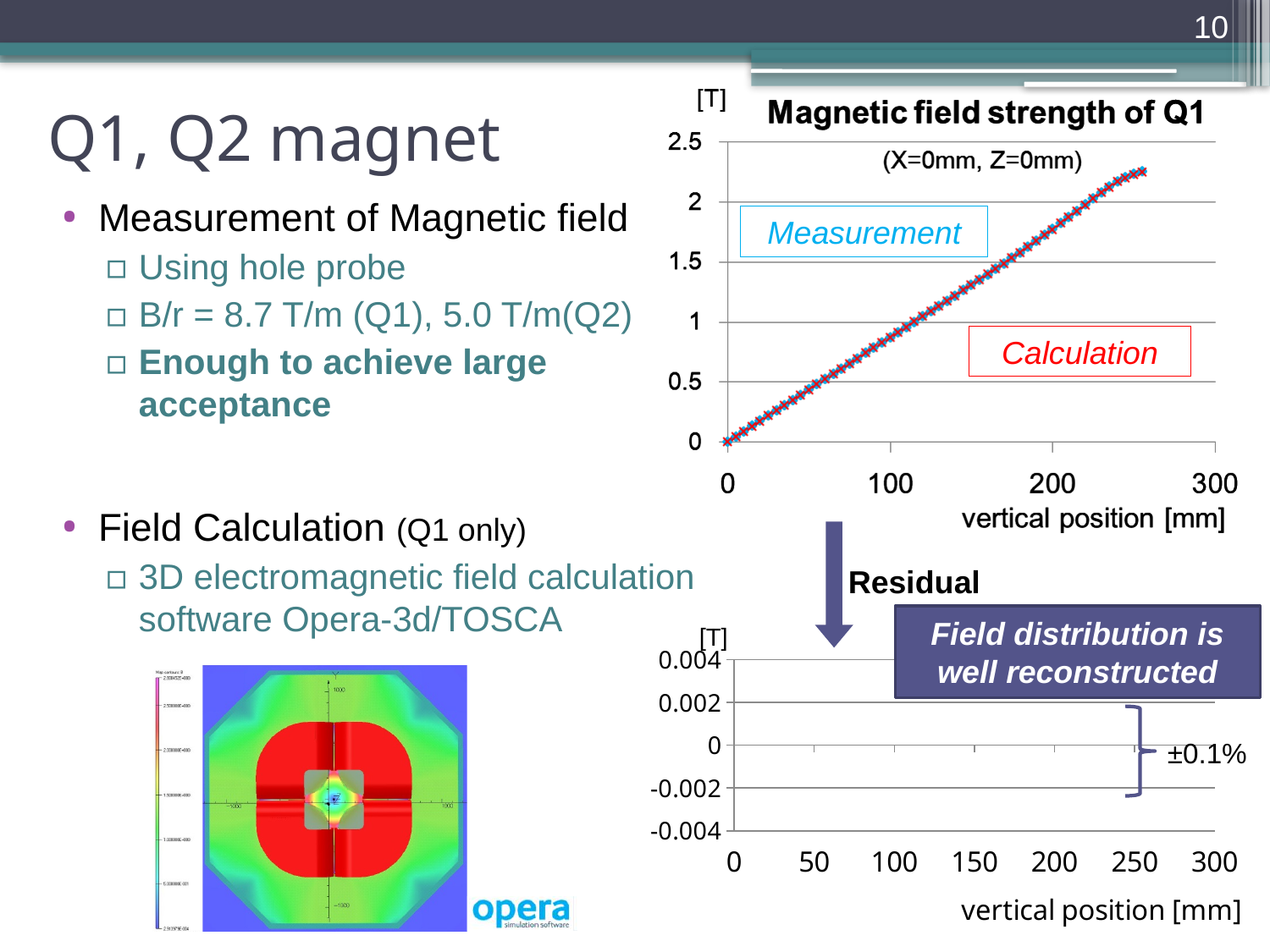
On the chart titled 'Magnetic field strength of Q1', is the field value at a vertical position of 200 mm greater or less than 1.5? greater On the chart titled 'Magnetic field strength of Q1', what are the names of the two series? Measurement and Calculation On the Residual chart at the bottom right, what percentage band is annotated next to the bracket? ±0.1% On the chart titled 'Magnetic field strength of Q1', is the highest plotted field value greater or less than 2.5? less On the chart titled 'Magnetic field strength of Q1', do the values rise or fall as vertical position increases? rise On the chart titled 'Magnetic field strength of Q1', what kind of chart is it? scatter chart On the chart titled 'Magnetic field strength of Q1', is the field value at a vertical position of 100 mm greater or less than 1? less On the chart titled 'Magnetic field strength of Q1', what is the label of the x axis? vertical position [mm] On the Residual chart at the bottom right, what is the lowest value shown on the y axis? -0.004 On the chart titled 'Magnetic field strength of Q1', how many series are shown? 2 On the chart titled 'Magnetic field strength of Q1', what is the maximum value shown on the y axis? 2.5